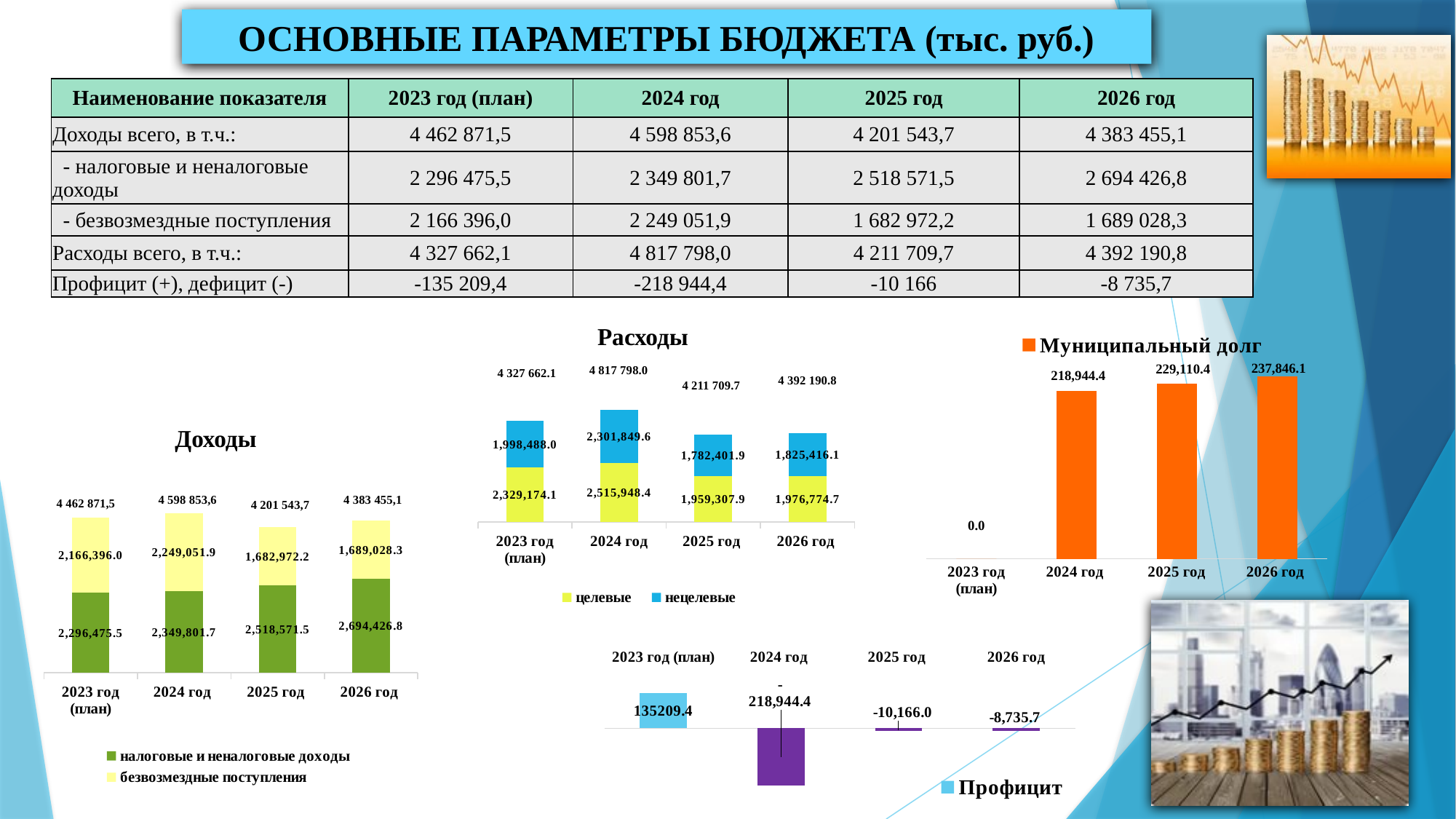
In the "Расходы" chart, what is the value of целевые for 2025 год? 1,959,307.9 In the "Доходы" chart, how many series does the legend list? 2 In the "Доходы" chart, what is the value of налоговые и неналоговые доходы for 2026 год? 2,694,426.8 In the "Доходы" chart, what is the total shown above the bar for 2024 год? 4 598 853,6 In the "Муниципальный долг" chart, do the values rise or fall from 2023 год (план) to 2026 год? rise In the "Доходы" chart, what is the value of безвозмездные поступления for 2025 год? 1,682,972.2 In the "Профицит" chart at the bottom, what is the value for 2026 год? -8,735.7 In the "Расходы" chart, which year has the highest total expenditure? 2024 год In the "Расходы" chart, what is the difference between целевые and нецелевые for 2023 год (план)? 330,686.1 In the "Муниципальный долг" chart, what is the value for 2025 год? 229,110.4 In the "Расходы" chart, what is the value of нецелевые for 2024 год? 2,301,849.6 What kind of chart is the "Муниципальный долг" chart? bar chart